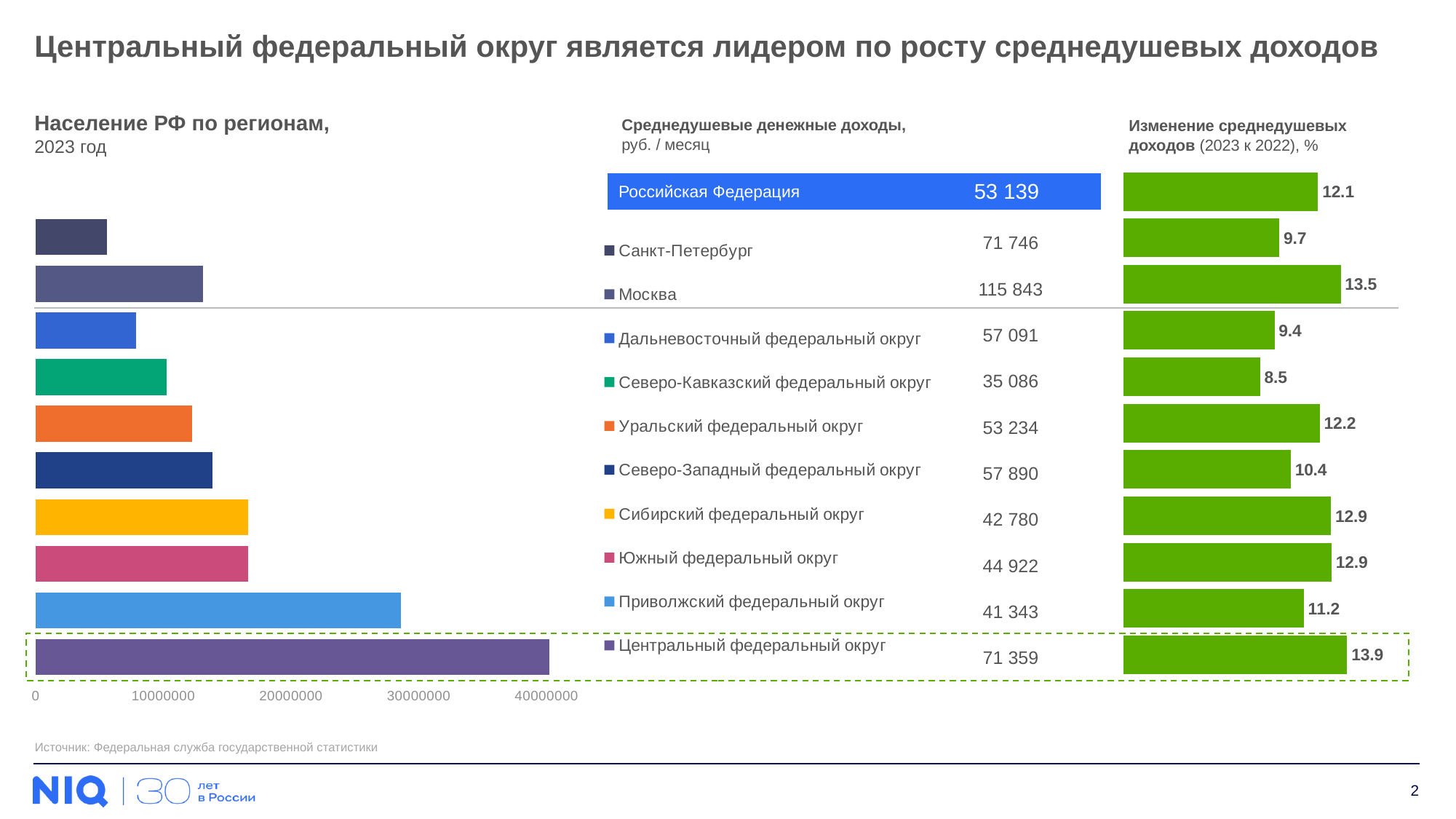
On the chart 'Среднедушевые денежные доходы', what is the value for Российская Федерация? 53 139 On the chart 'Население РФ по регионам', which region has the largest population? Центральный федеральный округ On the chart 'Население РФ по регионам', is the value for Приволжский федеральный округ greater or less than 20000000? greater On the chart 'Население РФ по регионам', is the value for Санкт-Петербург greater or less than 10000000? less On the chart 'Изменение среднедушевых доходов', what is the difference between Центральный федеральный округ and Российская Федерация? 1.8 On the chart 'Среднедушевые денежные доходы', what is the difference between Санкт-Петербург and Центральный федеральный округ? 387 On the chart 'Среднедушевые денежные доходы', which region has the highest value? Москва On the chart 'Среднедушевые денежные доходы', what is the value for Москва? 115 843 On the chart 'Изменение среднедушевых доходов', which region has the lowest value? Северо-Кавказский федеральный округ On the chart 'Среднедушевые денежные доходы', which region has the lowest value? Северо-Кавказский федеральный округ On the chart 'Изменение среднедушевых доходов', what is the value for Центральный федеральный округ? 13.9 On the chart 'Изменение среднедушевых доходов', which is larger: Санкт-Петербург or Москва? Москва